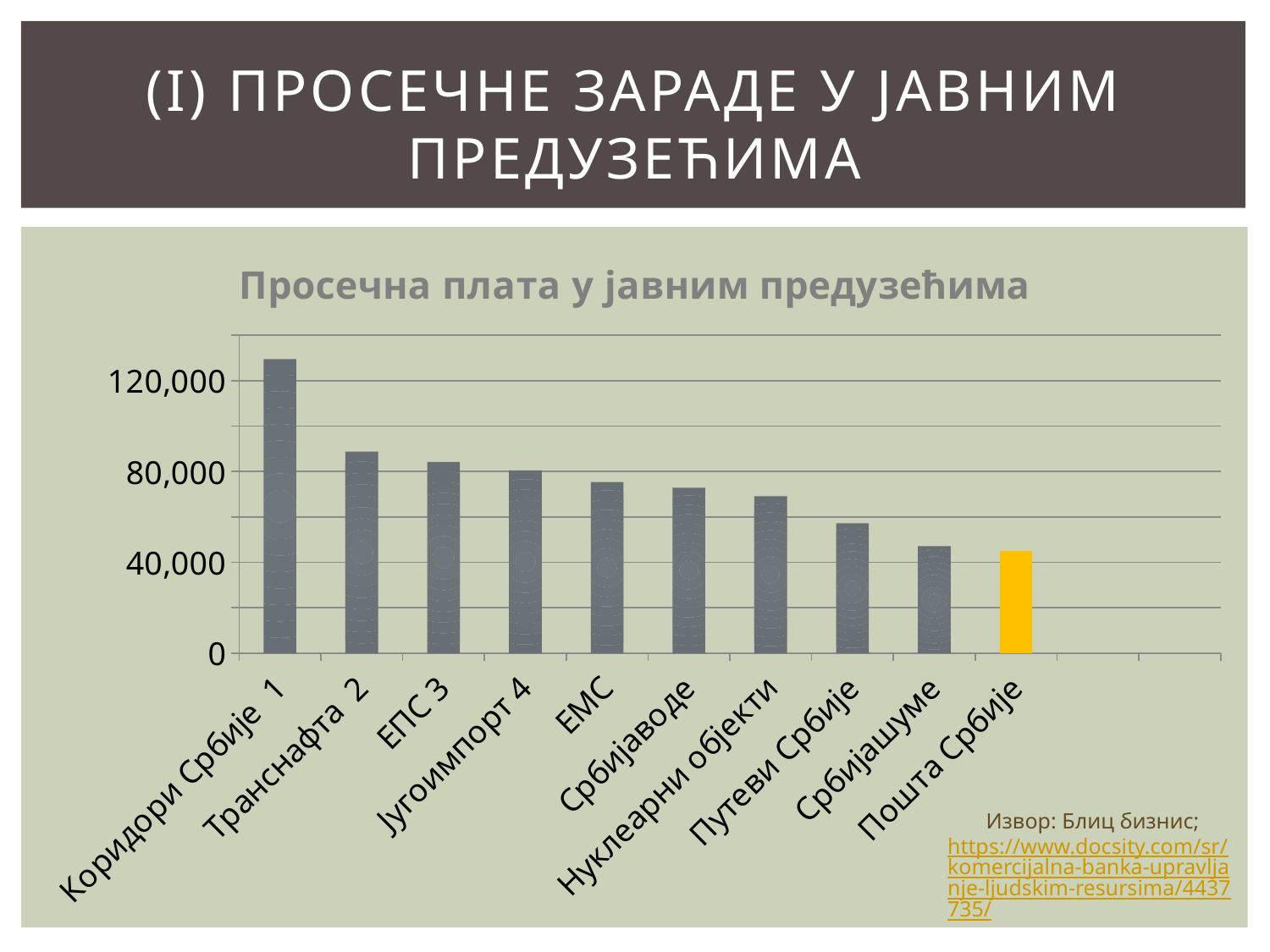
Which company has the highest average salary in the chart? Коридори Србије 1 Which company's bar is shown in a different colour (yellow) from the others? Пошта Србије Is the value for Нуклеарни објекти greater or less than 80,000? less What is the title of the chart? Просечна плата у јавним предузећима Is the value for Коридори Србије 1 greater or less than 120,000? greater Do the values rise or fall from left to right along the x axis? fall Is the value for Путеви Србије greater or less than 40,000? greater Which is larger, the value for Транснафта 2 or the value for ЕМС? Транснафта 2 What kind of chart is shown on the slide? bar chart How many companies (categories) are shown in the chart? 10